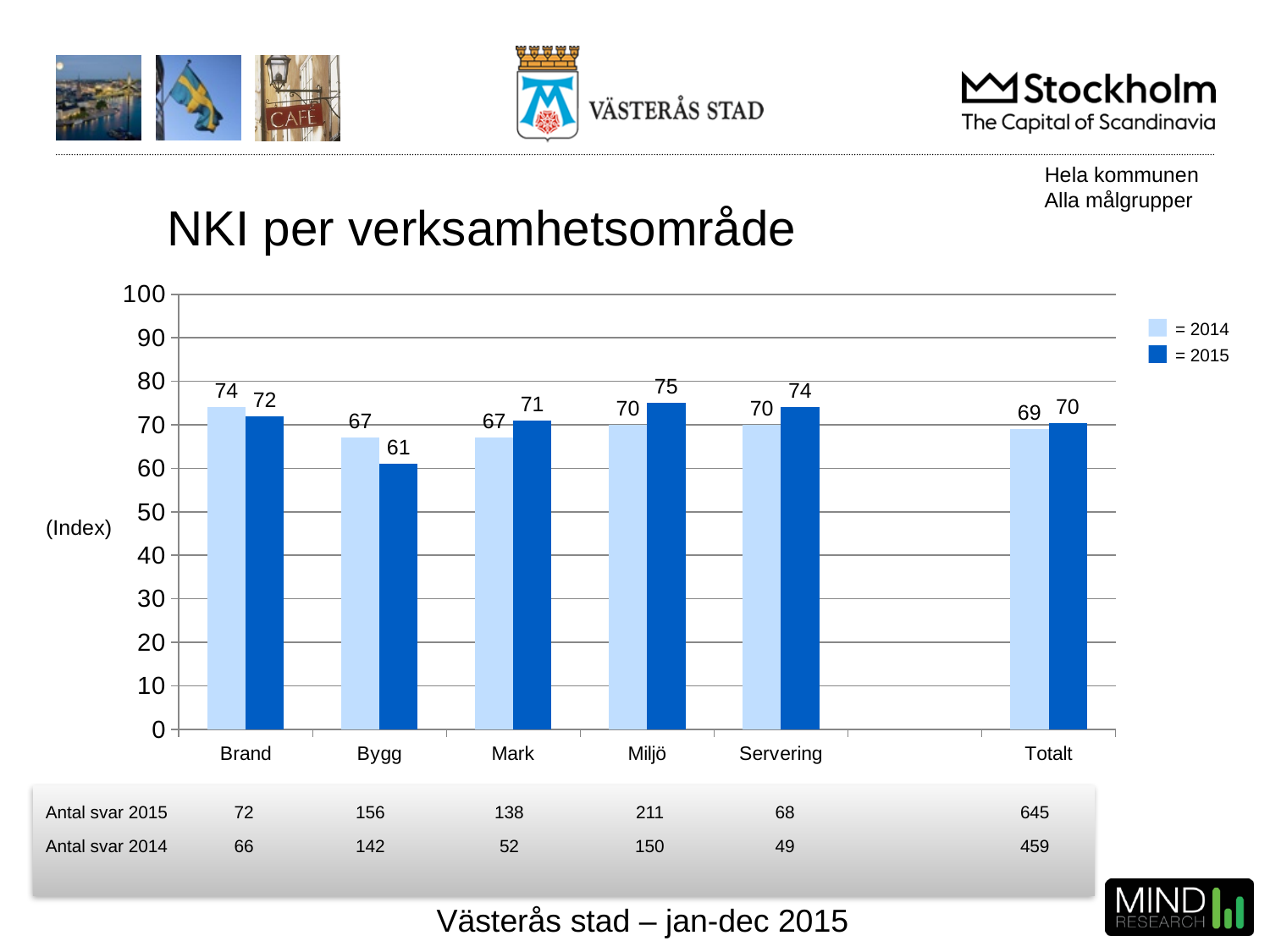
What is the difference between the 2015 NKI values for Miljö and Brand? 3 What kind of chart is shown on the slide? Bar chart What is the NKI value for Miljö in 2014? 70 Which category has the lowest NKI value in 2015? Bygg What is the title of the chart? NKI per verksamhetsområde How many categories are shown on the x axis of the chart? 6 How many series does the legend list? 2 What is the difference between the 2014 and 2015 NKI values for Bygg? 6 Which is larger, the 2014 or the 2015 NKI value for Servering? 2015 What is the NKI value for Totalt in 2015? 70 What is the NKI value for Bygg in 2015? 61 Which category has the highest NKI value in 2015? Miljö